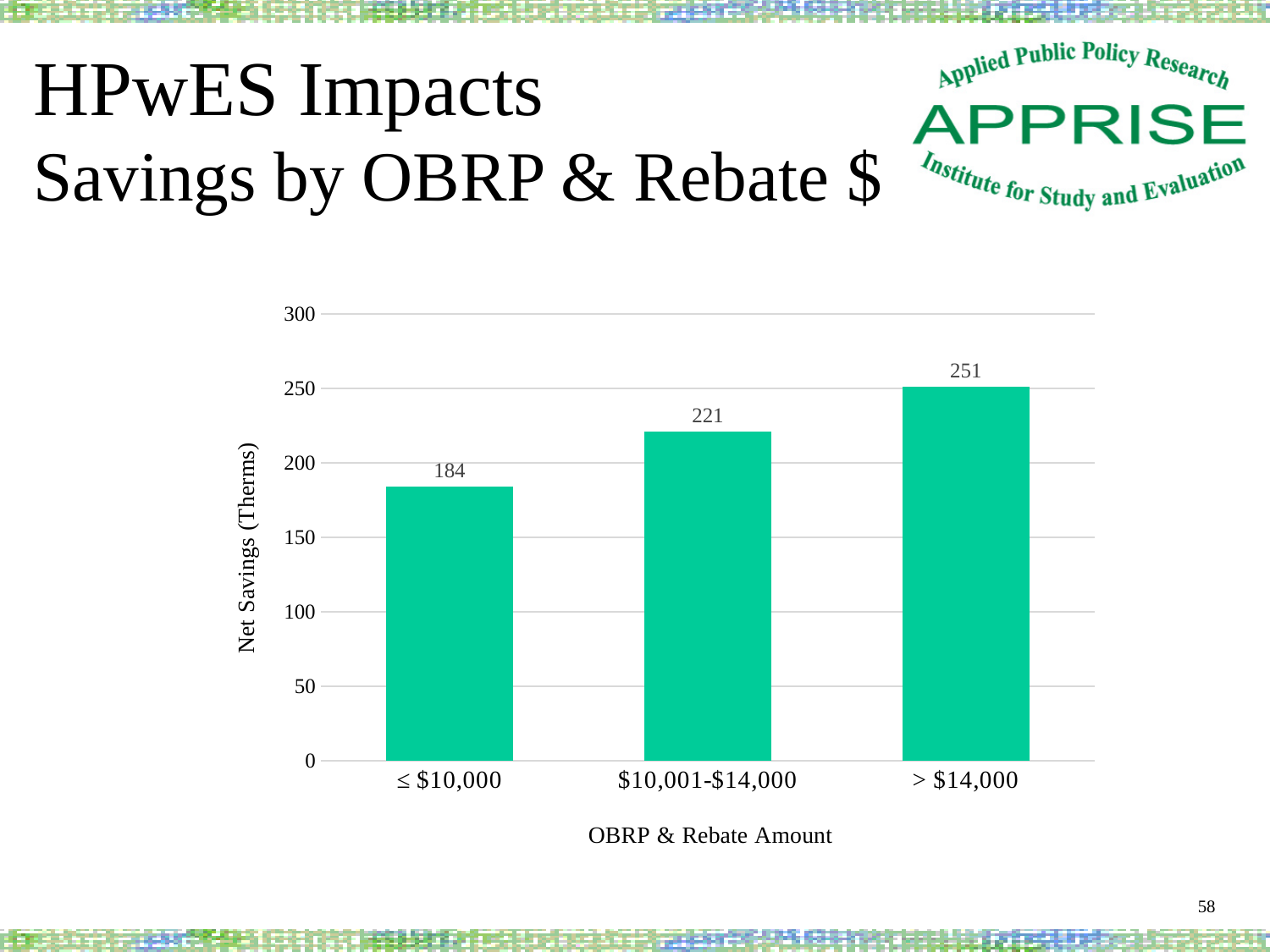
Which OBRP & Rebate Amount category has the highest net savings? > $14,000 What is the net savings in therms for the > $14,000 category? 251 Which OBRP & Rebate Amount category has the lowest net savings? ≤ $10,000 Which has higher net savings: the $10,001-$14,000 category or the > $14,000 category? > $14,000 What is the net savings in therms for the $10,001-$14,000 category? 221 Do net savings rise or fall as the OBRP & Rebate Amount increases along the x axis? Rise What is the difference in net savings between the > $14,000 and ≤ $10,000 categories? 67 Is the net savings for the ≤ $10,000 category greater or less than 200? less What is the difference in net savings between the $10,001-$14,000 and ≤ $10,000 categories? 37 What is the net savings in therms for the ≤ $10,000 OBRP & Rebate Amount category? 184 How many OBRP & Rebate Amount categories are shown in the chart? 3 What kind of chart is shown on the slide? Bar chart